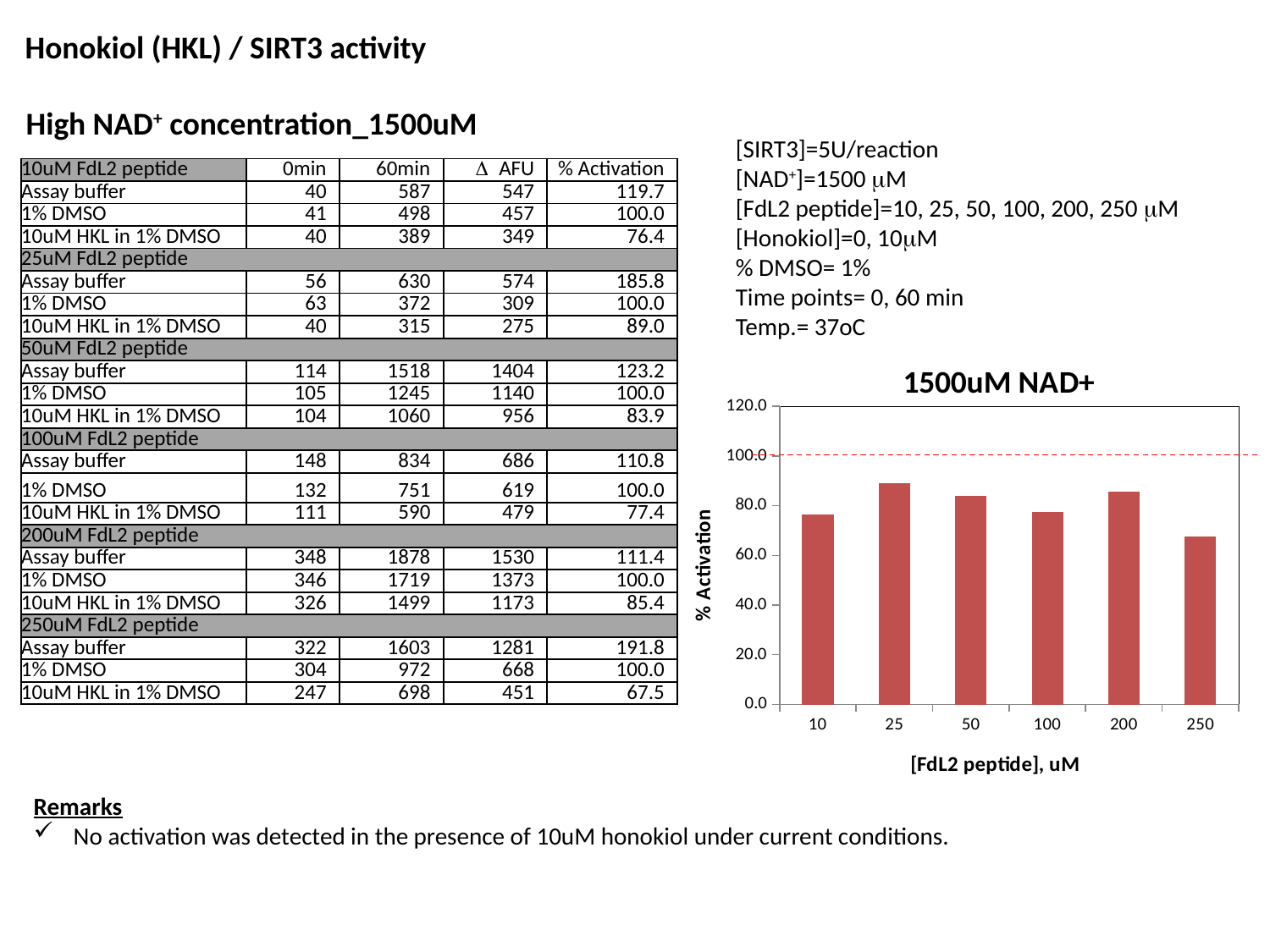
What is the label of the y axis of the chart? % Activation Is the % Activation for 10 uM FdL2 peptide greater or less than 60? greater Which has the higher % Activation in the chart, 25 uM or 250 uM FdL2 peptide? 25 Is the % Activation for 200 uM FdL2 peptide greater or less than 100? less How many FdL2 peptide concentrations are plotted on the x axis of the chart? 6 What kind of chart is shown on the slide? bar chart Which FdL2 peptide concentration has the highest % Activation in the chart? 25 Is the % Activation for 250 uM FdL2 peptide greater or less than 80? less Which has the higher % Activation in the chart, 10 uM or 25 uM FdL2 peptide? 25 Which FdL2 peptide concentration has the lowest % Activation in the chart? 250 What is the title of the chart? 1500uM NAD+